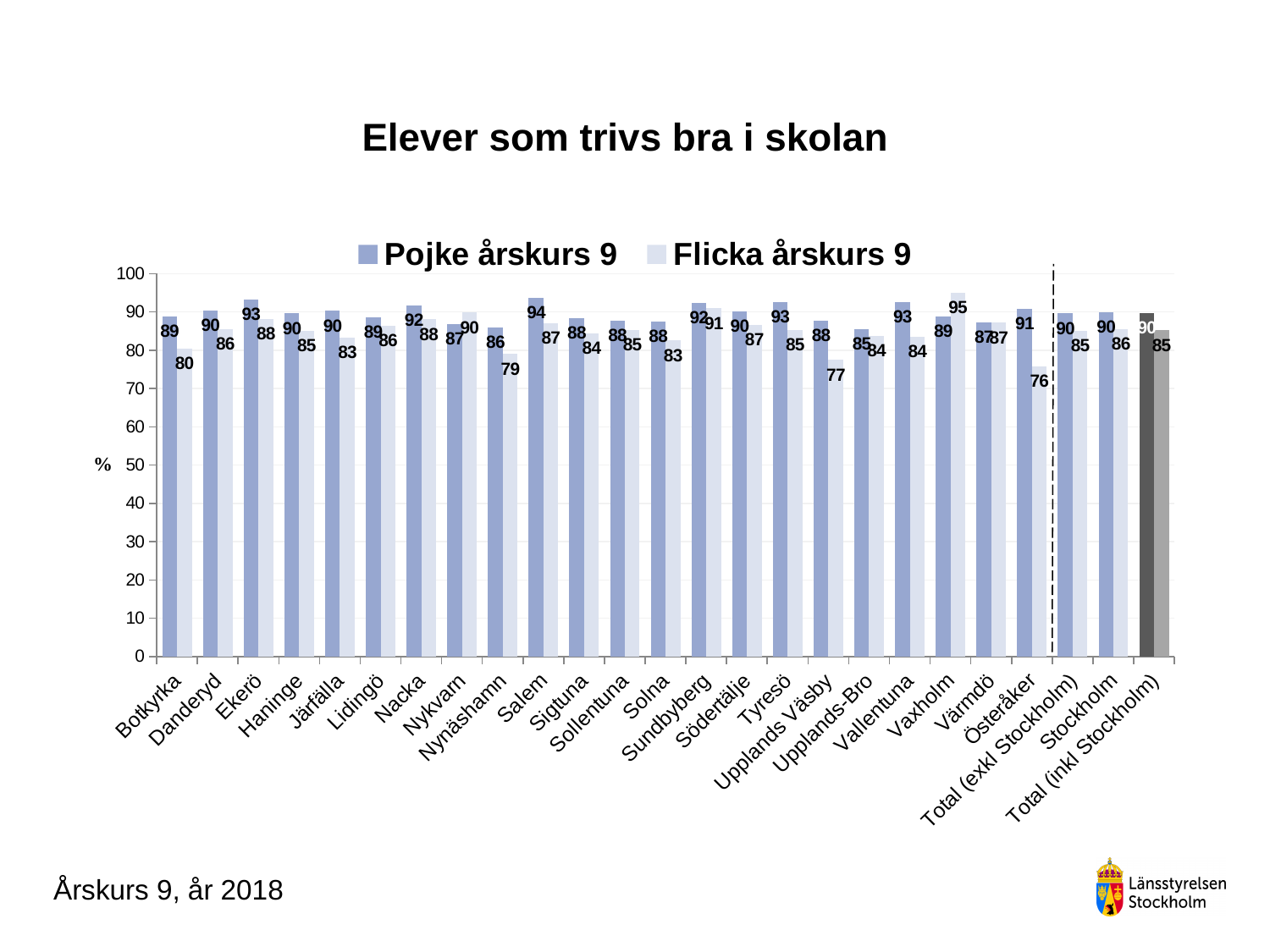
What kind of chart is shown? Bar chart What is the difference between Pojke årskurs 9 and Flicka årskurs 9 in Österåker? 15 What is the value for Flicka årskurs 9 in Vaxholm? 95 What is the title of the chart? Elever som trivs bra i skolan How many categories are shown on the x axis? 25 Which category has the lowest value for Flicka årskurs 9? Österåker What is the value for Flicka årskurs 9 in Österåker? 76 Which category has the lowest value for Pojke årskurs 9? Upplands-Bro How many series does the legend list? 2 Which is larger in Nykvarn, the value for Pojke årskurs 9 or Flicka årskurs 9? Flicka årskurs 9 What is the value for Pojke årskurs 9 in Salem? 94 Which category has the highest value for Pojke årskurs 9? Salem